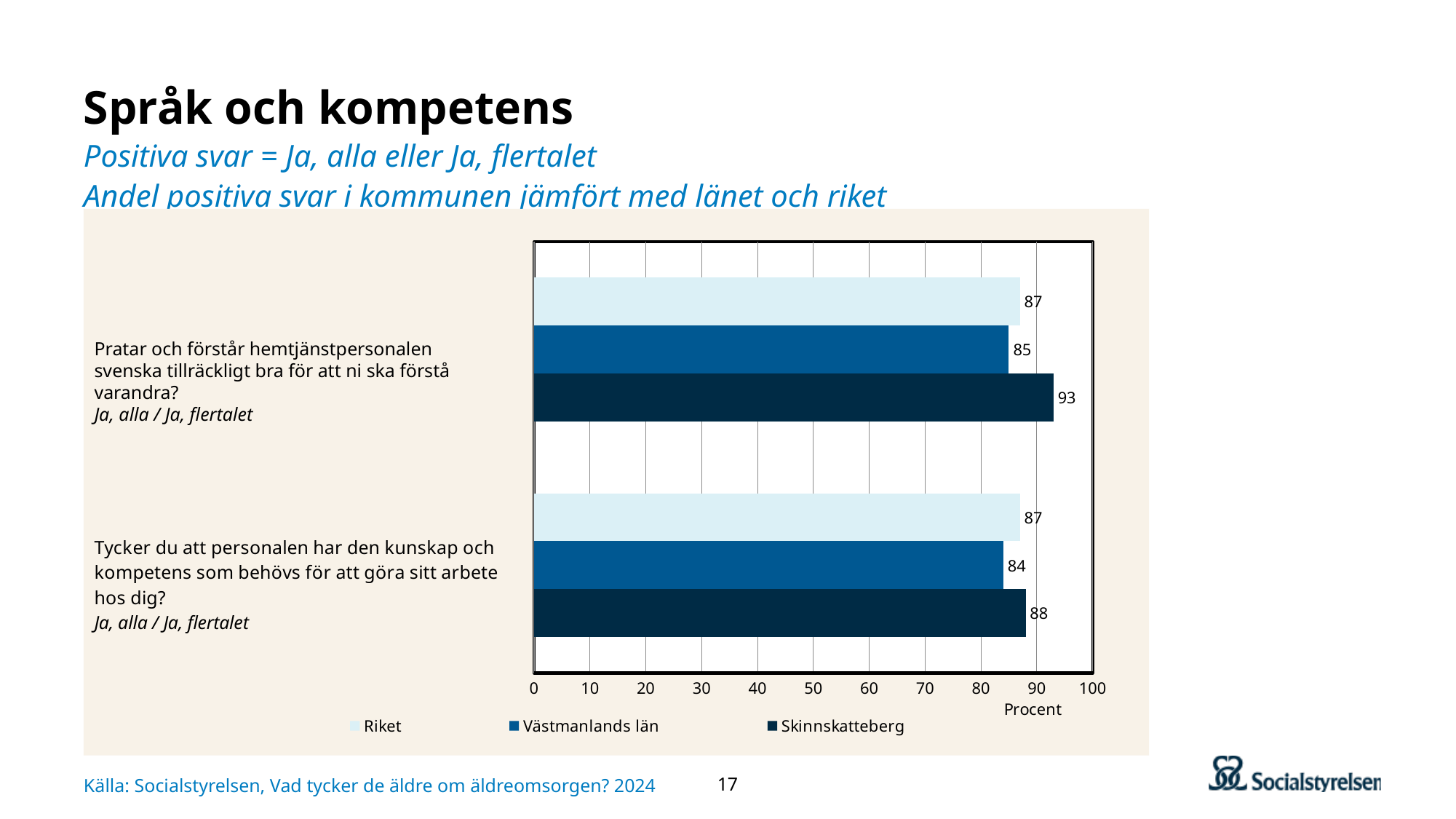
Which is larger: the Skinnskatteberg value for the Swedish-language question or the Skinnskatteberg value for the knowledge and competence question? The Swedish-language question (93) How many series does the legend list? 3 What is the value for Skinnskatteberg on the question about whether the home care staff speak and understand Swedish well enough? 93 What is the value for Västmanlands län on the question about whether the staff have the knowledge and competence needed? 84 Which series has the highest value on the question about whether the home care staff speak and understand Swedish well enough? Skinnskatteberg Which series has the lowest value on the question about whether the staff have the knowledge and competence needed? Västmanlands län What kind of chart is shown on the slide? Bar chart What is the value for Riket on the question about whether the staff have the knowledge and competence needed? 87 What is the difference between the Skinnskatteberg and Västmanlands län values on the question about whether the home care staff speak and understand Swedish well enough? 8 What is the difference between the Skinnskatteberg and Riket values on the question about whether the staff have the knowledge and competence needed? 1 What is the value for Västmanlands län on the question about whether the home care staff speak and understand Swedish well enough? 85 What unit is shown on the x axis of the chart? Procent